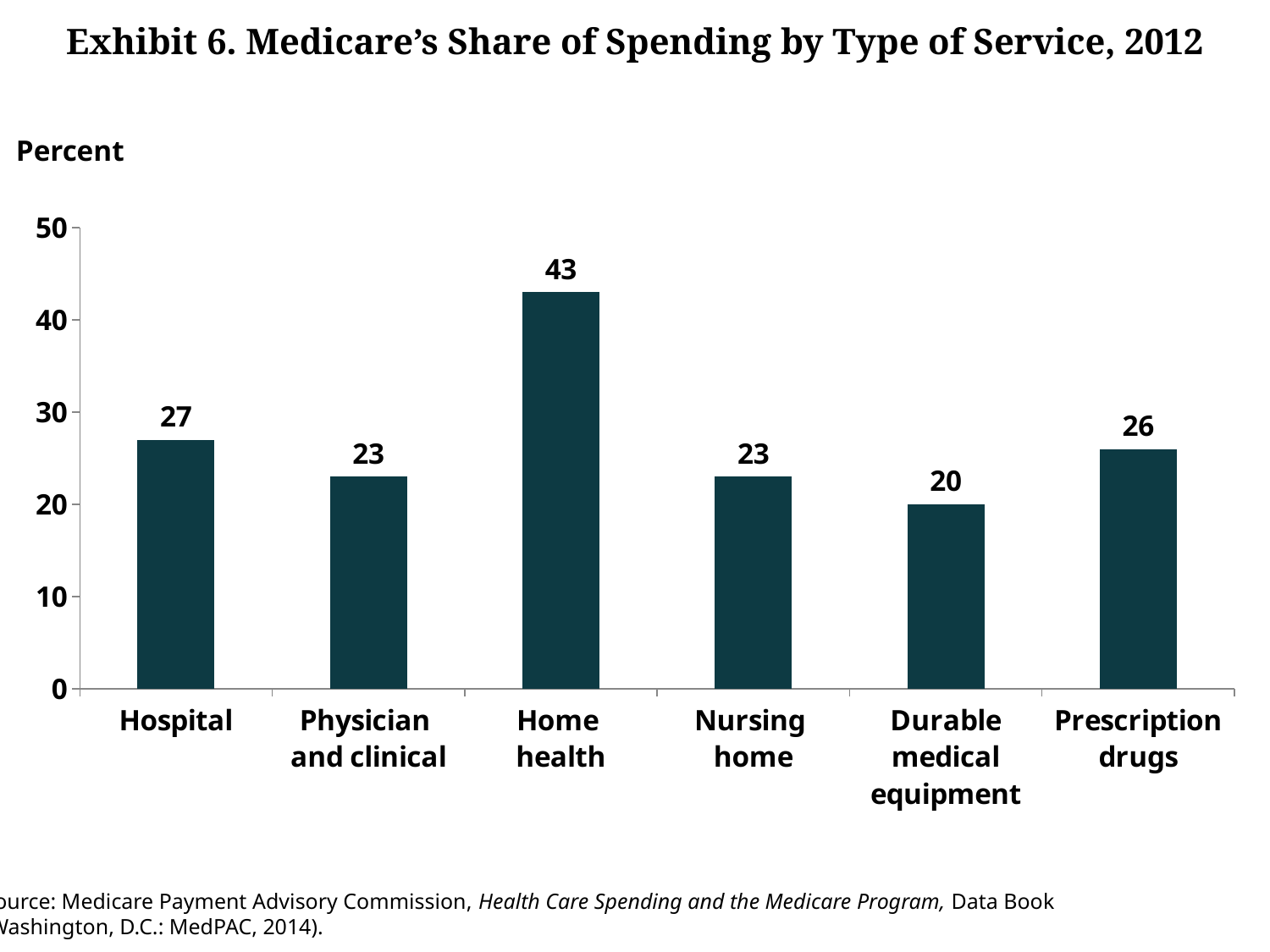
What is Medicare's share of spending for Durable medical equipment? 20 Which type of service has the lowest Medicare share of spending? Durable medical equipment What is Medicare's share of spending for Hospital services? 27 What is Medicare's share of spending for Home health? 43 What is the difference between the Medicare share for Home health and for Hospital? 16 Which type of service has the highest Medicare share of spending? Home health What kind of chart is shown on the slide? Bar chart What is Medicare's share of spending for Prescription drugs? 26 Which has a larger Medicare share of spending, Hospital or Prescription drugs? Hospital What unit is shown on the vertical axis label of the chart? Percent How many types of service are shown in the chart? 6 Is the value for Home health greater or less than 40? greater